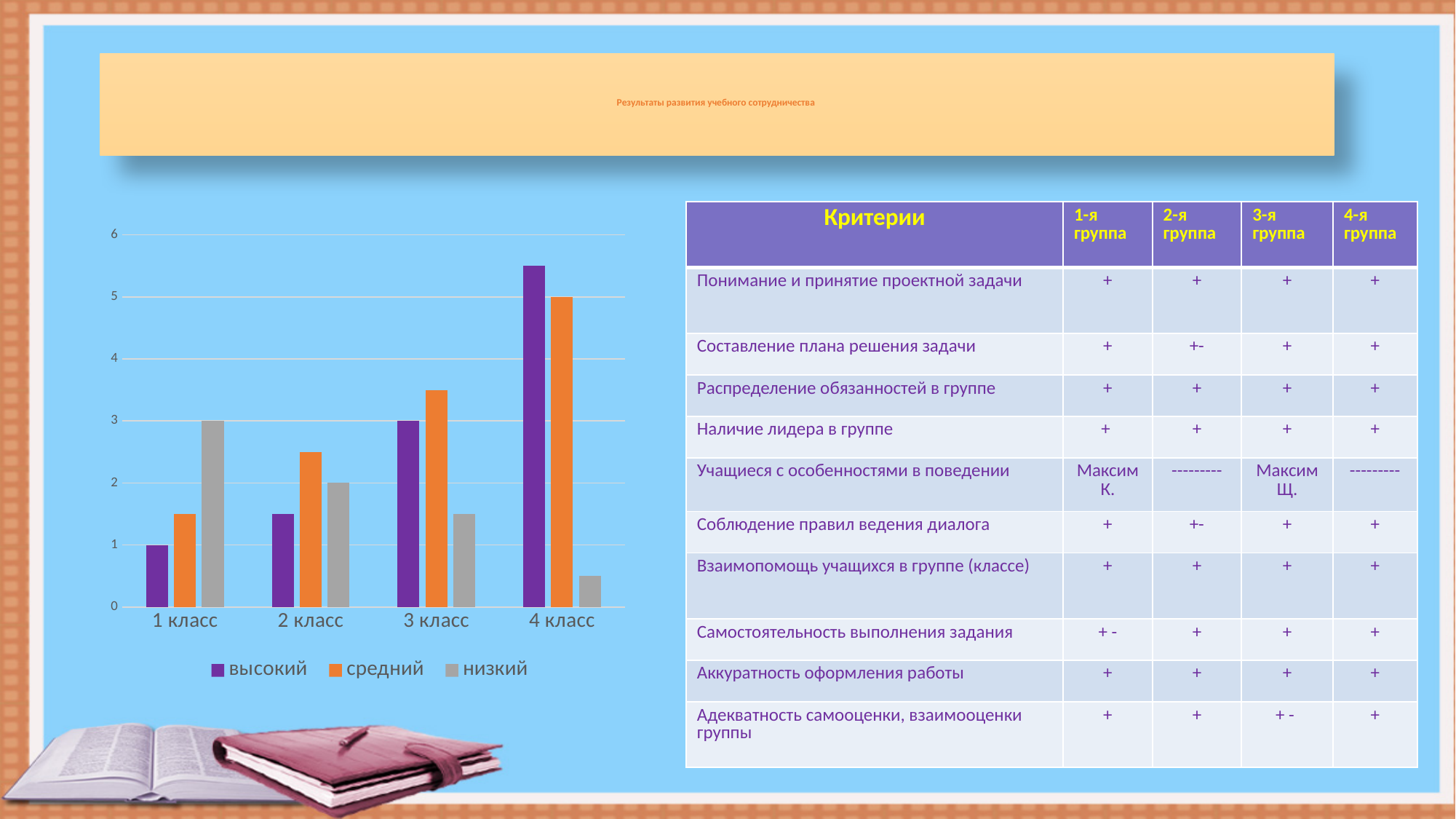
Is the value of the высокий series for 4 класс greater or less than 5? greater Which category has the lowest value for the низкий series? 4 класс What is the value of the высокий series for 1 класс? 1 How many series does the chart legend list? 3 What is the value of the высокий series for 3 класс? 3 What kind of chart is shown on the left of the slide? bar chart How many categories are shown on the x axis of the chart? 4 Does the высокий series rise or fall from 1 класс to 4 класс? rise What is the value of the низкий series for 1 класс? 3 For 2 класс, which series has the larger value: средний or низкий? средний Which category has the highest value for the высокий series? 4 класс What is the value of the средний series for 4 класс? 5